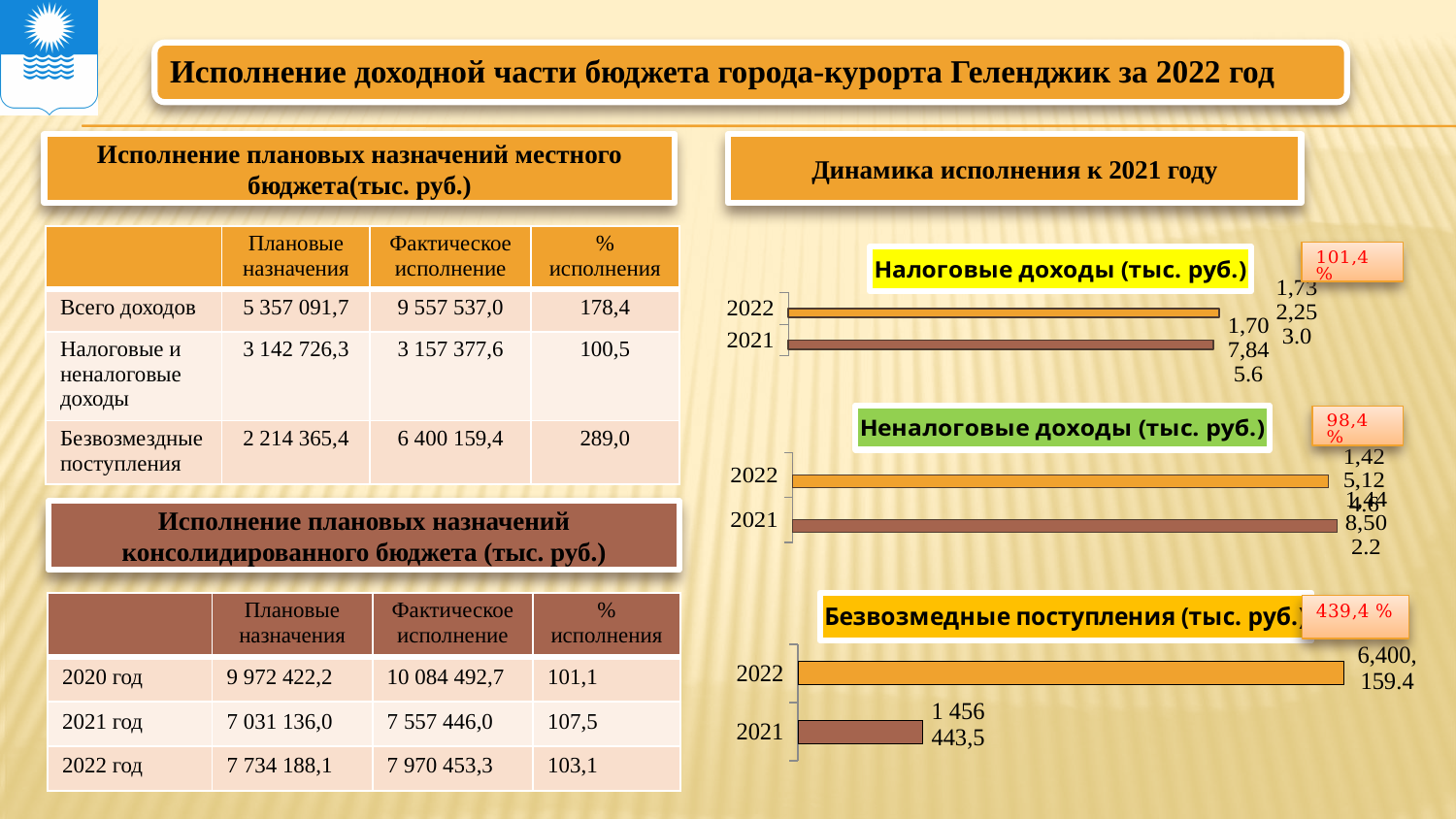
How many bar charts are shown under the heading "Динамика исполнения к 2021 году"? 3 What kind of chart is the "Безвозмедные поступления (тыс. руб.)" chart? bar chart In the "Безвозмедные поступления (тыс. руб.)" chart, which year has the larger value, 2022 or 2021? 2022 In the "Безвозмедные поступления (тыс. руб.)" chart, what is the difference between the 2022 and 2021 values? 4 943 715,9 In the "Безвозмедные поступления (тыс. руб.)" chart, which year has the lowest value? 2021 In the "Безвозмедные поступления (тыс. руб.)" chart, what is the value for 2021? 1 456 443,5 In the "Безвозмедные поступления (тыс. руб.)" chart, what is the value for 2022? 6,400,159.4 What percentage is shown in the badge next to the "Налоговые доходы (тыс. руб.)" chart? 101,4 % How many bars does the "Налоговые доходы (тыс. руб.)" chart show? 2 What percentage is shown in the badge next to the "Безвозмедные поступления (тыс. руб.)" chart? 439,4 % In the "Безвозмедные поступления (тыс. руб.)" chart, which year has the highest value? 2022 How many years are compared in the "Неналоговые доходы (тыс. руб.)" chart? 2